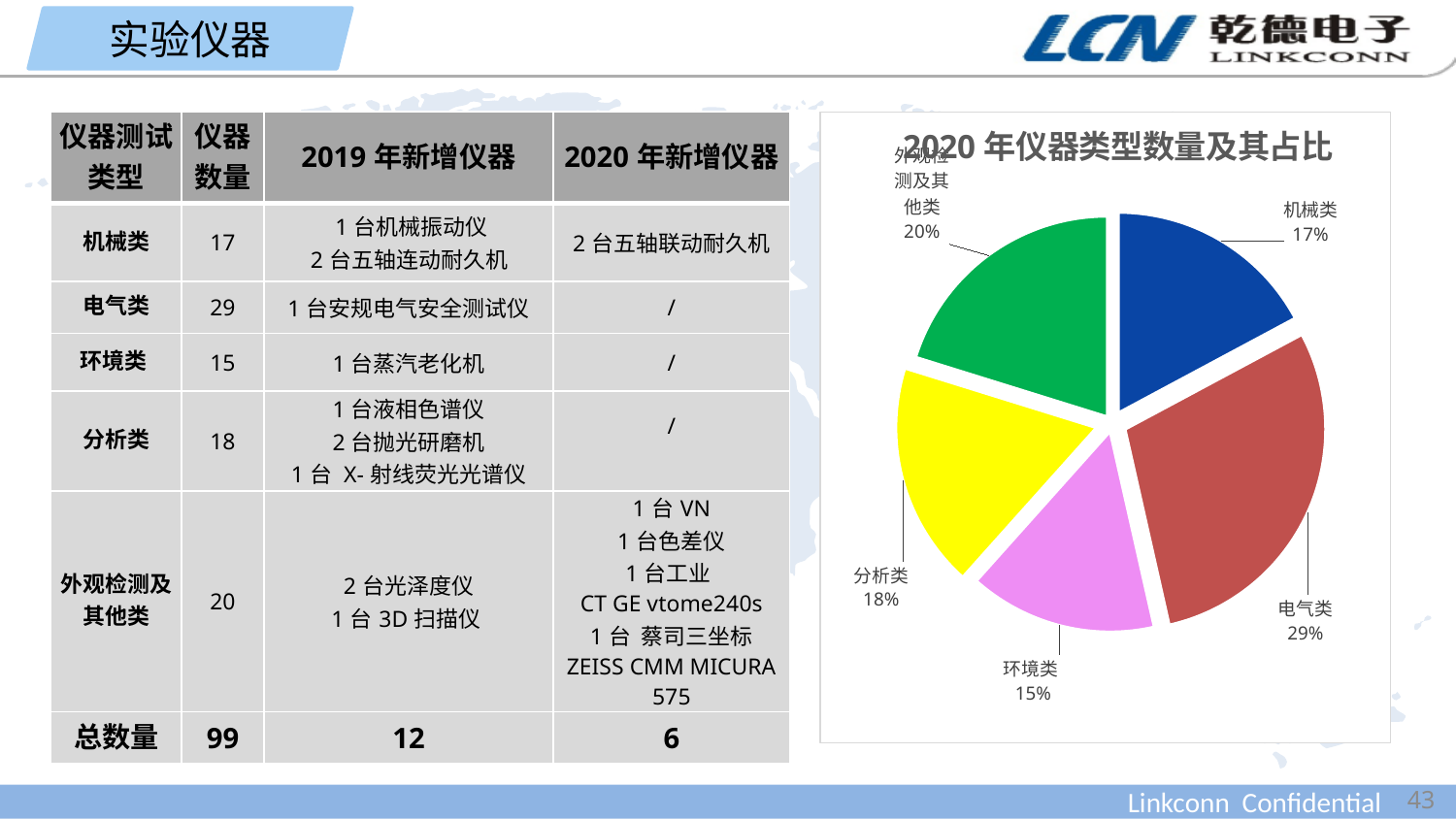
What share of the pie does 环境类 represent? 15% How many slices does the pie chart have? 5 What is the title of the pie chart? 2020 年仪器类型数量及其占比 What is the difference in percentage points between 电气类 and 环境类? 14 Which slice is larger, 分析类 or 机械类? 分析类 Which category has the largest slice in the pie chart? 电气类 What share of the pie does 外观检测及其他类 represent? 20% What type of chart is shown on the slide? pie chart What share of the pie does 机械类 represent? 17% Which category has the smallest slice in the pie chart? 环境类